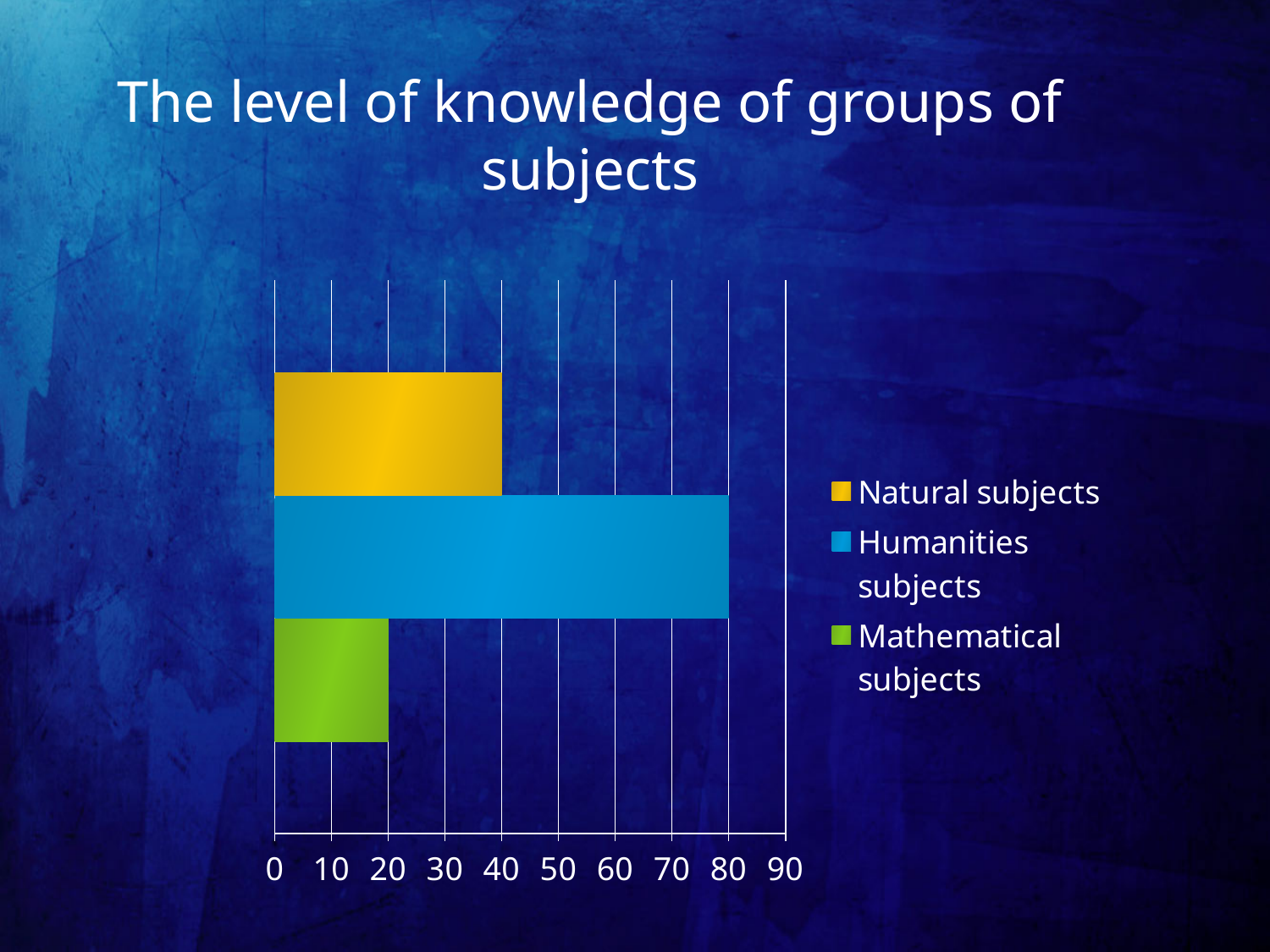
Which group of subjects has the highest value? Humanities subjects What type of chart is shown on the slide? bar chart What is the value for Natural subjects? 40 What is the value for Humanities subjects? 80 Which is larger, the value for Natural subjects or the value for Mathematical subjects? Natural subjects How many series does the legend list? 3 What is the value for Mathematical subjects? 20 What is the difference between the values for Humanities subjects and Natural subjects? 40 What is the title of the chart on the slide? The level of knowledge of groups of subjects Is the value for Humanities subjects greater or less than 50? greater What is the difference between the values for Natural subjects and Mathematical subjects? 20 Which group of subjects has the lowest value? Mathematical subjects